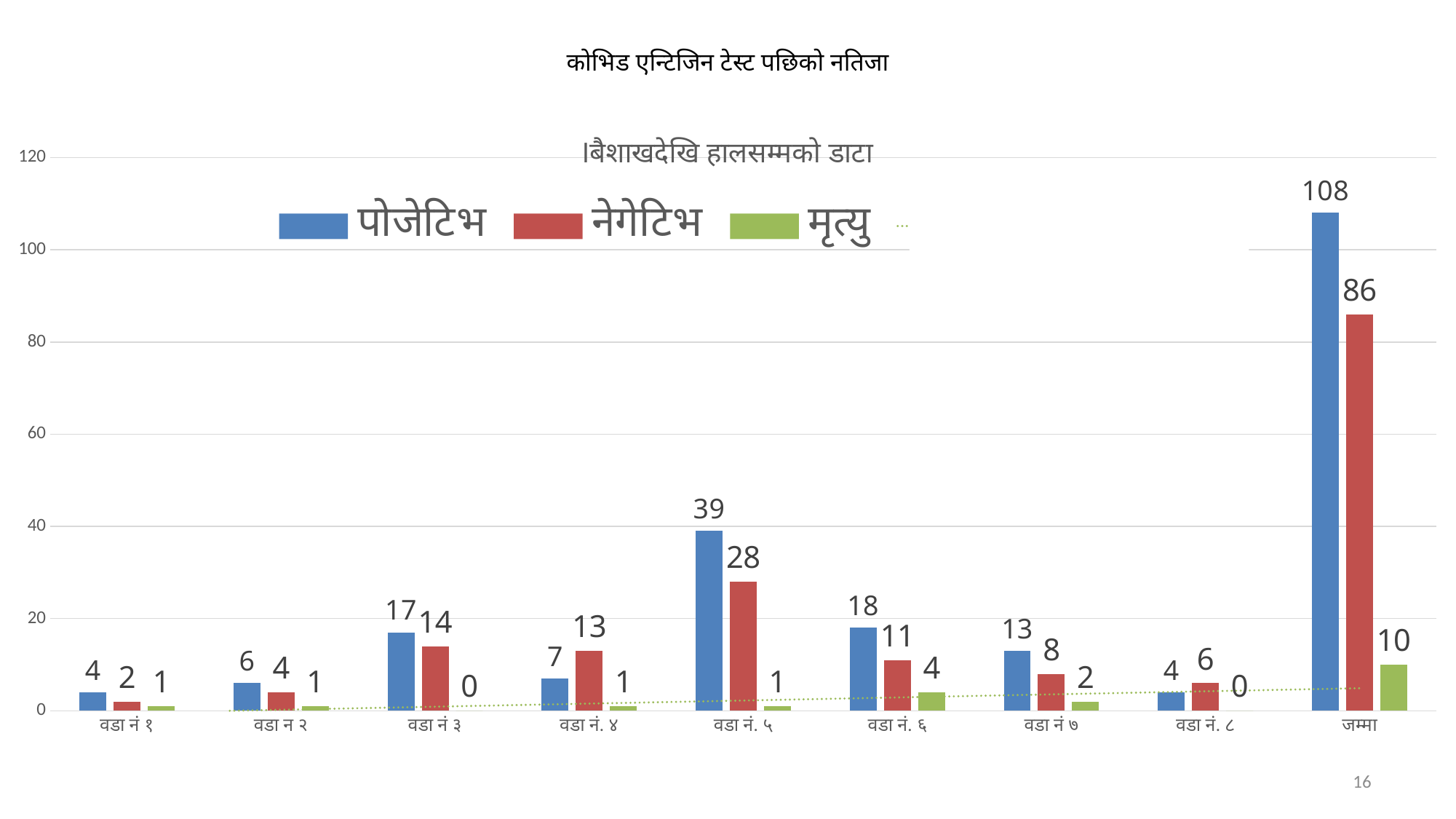
What is the difference between the पोजेटिभ and नेगेटिभ values for जम्मा? 22 How many categories are shown on the x axis? 9 Which colour represents the मृत्यु series? green What is the पोजेटिभ value for वडा नं. ५? 39 Which is larger for वडा नं. ४, the पोजेटिभ value or the नेगेटिभ value? नेगेटिभ How many data series are listed in the legend? 3 Which category has the highest पोजेटिभ value? जम्मा What is the मृत्यु value for वडा नं. ६? 4 What is the नेगेटिभ value for जम्मा? 86 What type of chart is shown on the slide? bar chart Excluding जम्मा, which ward has the highest नेगेटिभ value? वडा नं. ५ What is the difference between the पोजेटिभ values for वडा नं. ५ and वडा नं. ६? 21